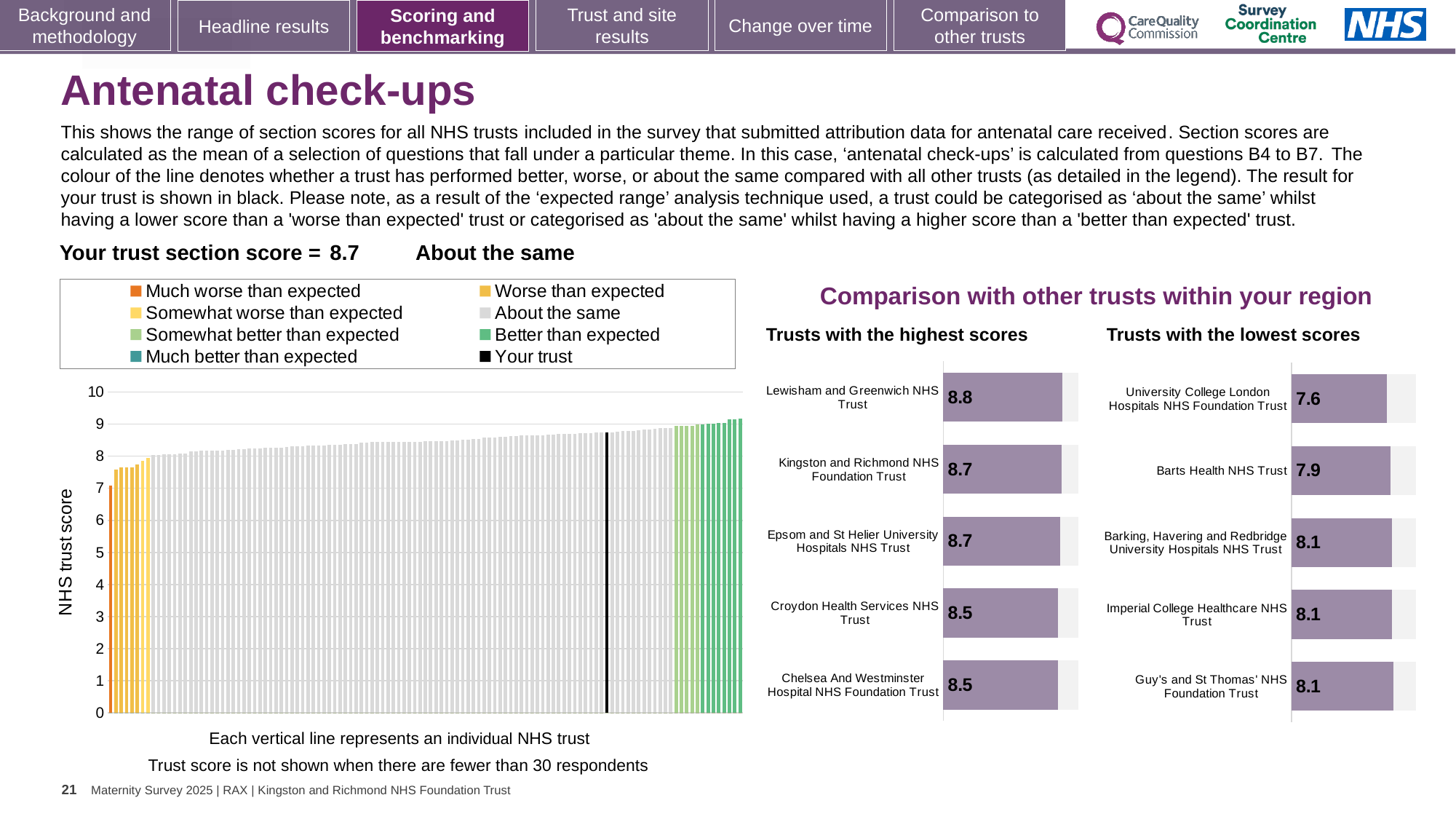
In the large chart on the left, is the value of the tallest bar greater or less than 9? greater In the 'Trusts with the highest scores' chart, what is the difference between the scores of Lewisham and Greenwich NHS Trust and Croydon Health Services NHS Trust? 0.3 In the 'Trusts with the highest scores' chart, which trust has the highest score? Lewisham and Greenwich NHS Trust How many trusts are listed in the 'Trusts with the highest scores' chart? 5 In the 'Trusts with the lowest scores' chart, what is the score for Imperial College Healthcare NHS Trust? 8.1 How many entries does the legend of the large chart on the left list? 8 What kind of chart is the large chart on the left showing NHS trust scores? Bar chart In the 'Trusts with the lowest scores' chart, what is the score for University College London Hospitals NHS Foundation Trust? 7.6 In the 'Trusts with the highest scores' chart, what is the score for Lewisham and Greenwich NHS Trust? 8.8 In the 'Trusts with the lowest scores' chart, which has the larger score: Barts Health NHS Trust or University College London Hospitals NHS Foundation Trust? Barts Health NHS Trust In the 'Trusts with the lowest scores' chart, which trust has the lowest score? University College London Hospitals NHS Foundation Trust In the large chart on the left, do the trust scores rise or fall from left to right? Rise